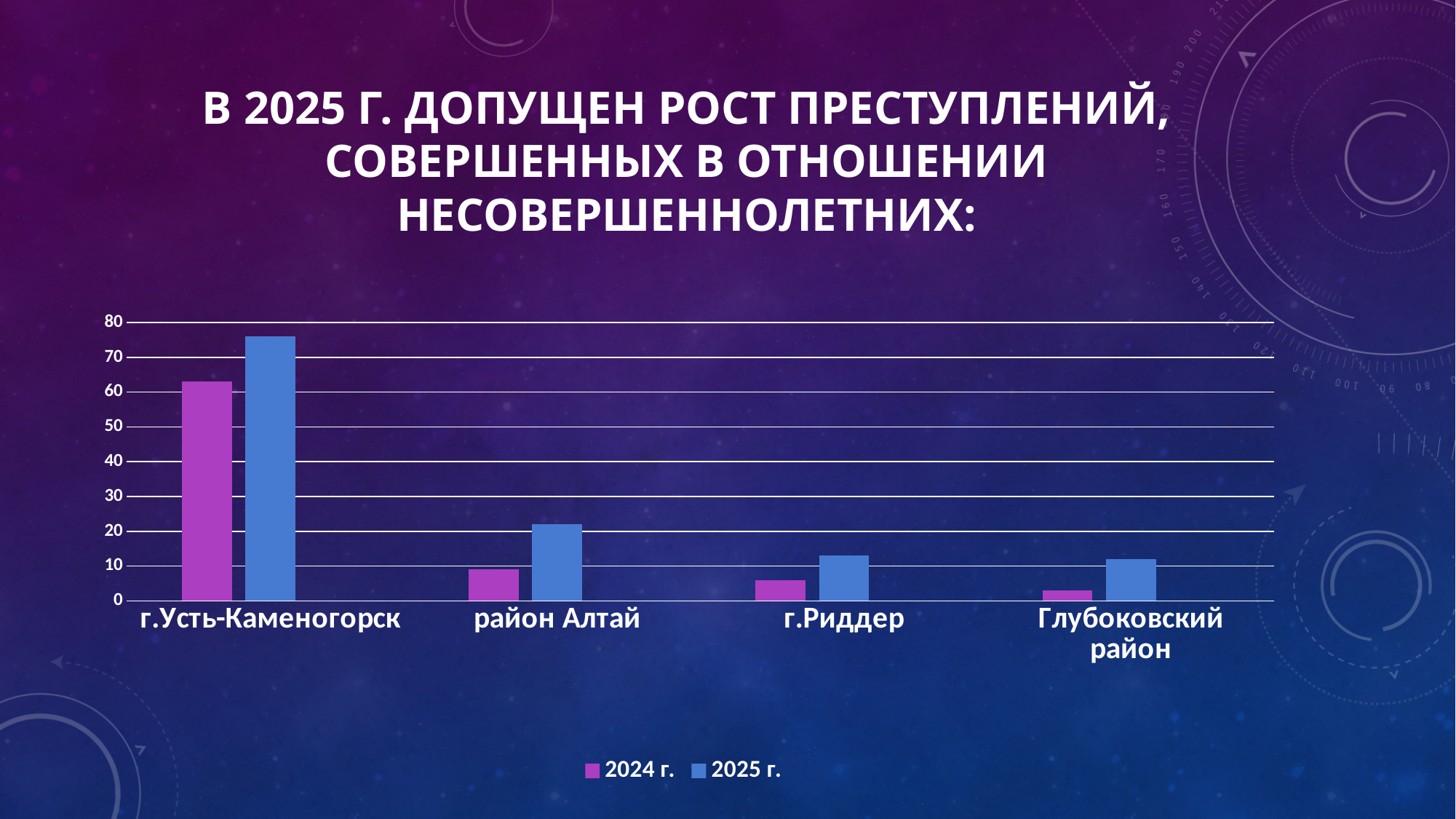
Is the 2024 г. value for г.Риддер greater or less than 10? less Which category has the lowest value for the 2024 г. series? Глубоковский район How many series does the chart legend list? 2 Which is larger: the 2025 г. value for район Алтай or the 2025 г. value for г.Риддер? район Алтай What kind of chart is shown on the slide? bar chart How many categories (regions) are shown on the x axis of the chart? 4 For Глубоковский район, which series has the larger value, 2024 г. or 2025 г.? 2025 г. Which category has the highest value for the 2025 г. series? г.Усть-Каменогорск Which series is shown in blue in the chart legend? 2025 г. Is the 2025 г. value for район Алтай greater or less than 20? greater Is the 2024 г. value for г.Усть-Каменогорск greater or less than 60? greater